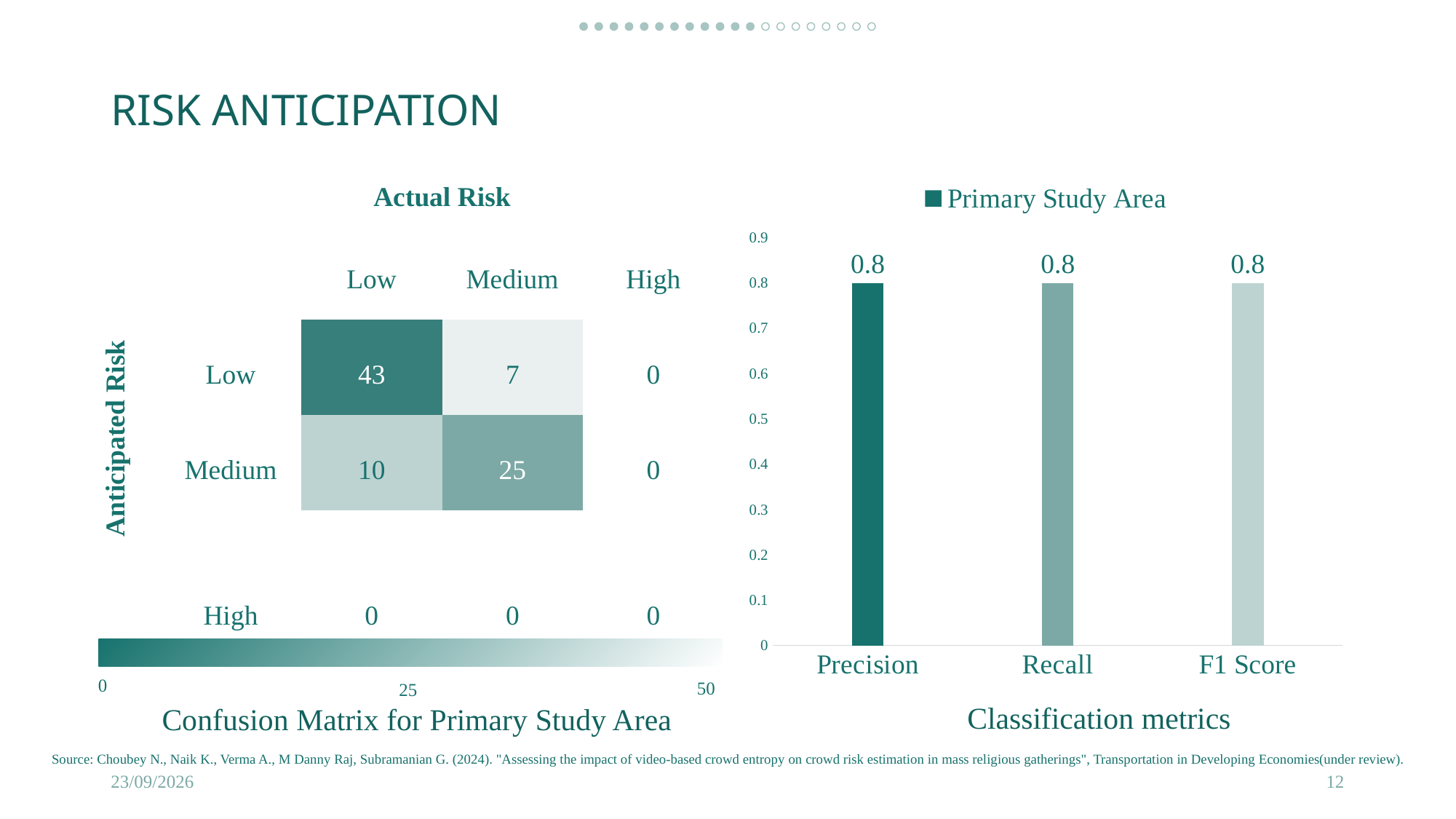
In the Classification metrics chart, what is the value for F1 Score? 0.8 In the Classification metrics chart, is the value for Recall greater or less than 0.5? greater In the Classification metrics chart, how many categories are shown on the x axis? 3 In the Confusion Matrix for Primary Study Area, which cell has the highest value? Anticipated Low, Actual Low (43) In the Confusion Matrix for Primary Study Area, what is the value for Anticipated Risk Low and Actual Risk Low? 43 In the Classification metrics chart, what is the value for Precision? 0.8 In the Confusion Matrix for Primary Study Area, what is the total of the Anticipated Risk Low row? 50 What kind of chart is the Classification metrics chart? bar chart In the Classification metrics chart, what series name is shown in the legend? Primary Study Area In the Confusion Matrix for Primary Study Area, what is the difference between the Low/Low cell (43) and the Medium/Medium cell (25)? 18 In the Confusion Matrix for Primary Study Area, what is the value for Anticipated Risk Medium and Actual Risk Low? 10 In the Classification metrics chart, how many series does the legend list? 1